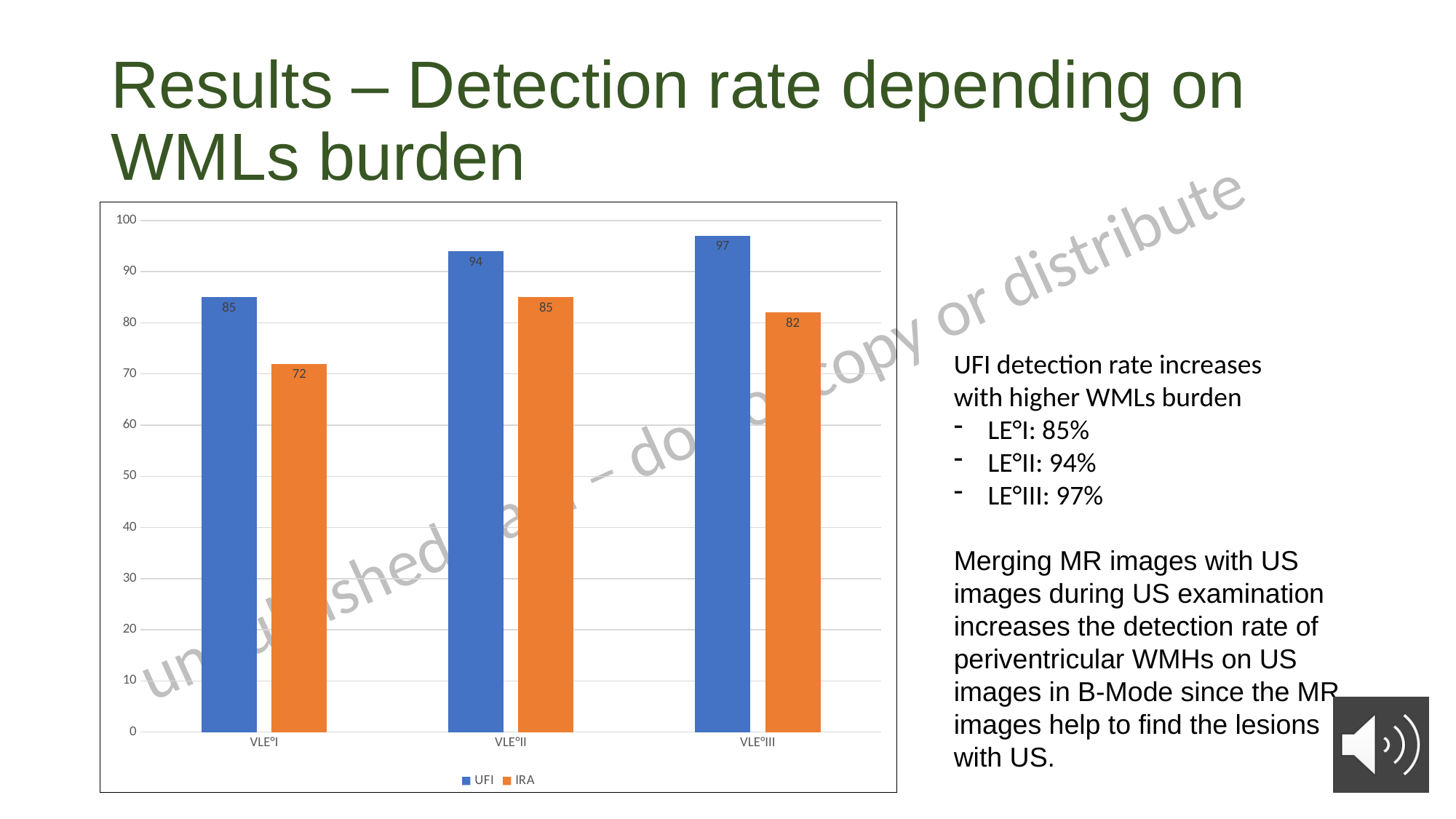
What is the difference between the UFI and IRA values for VLE°III? 15 Which category has the highest UFI value? VLE°III What kind of chart is shown on the slide? Bar chart How many series does the legend list? 2 How many categories are shown on the x axis? 3 What is the IRA value for VLE°I? 72 Which is larger for VLE°II, the UFI value or the IRA value? UFI Do the UFI values rise or fall from VLE°I to VLE°III? Rise What is the UFI value for VLE°I? 85 Which category has the lowest IRA value? VLE°I What is the UFI value for VLE°III? 97 What is the IRA value for VLE°II? 85